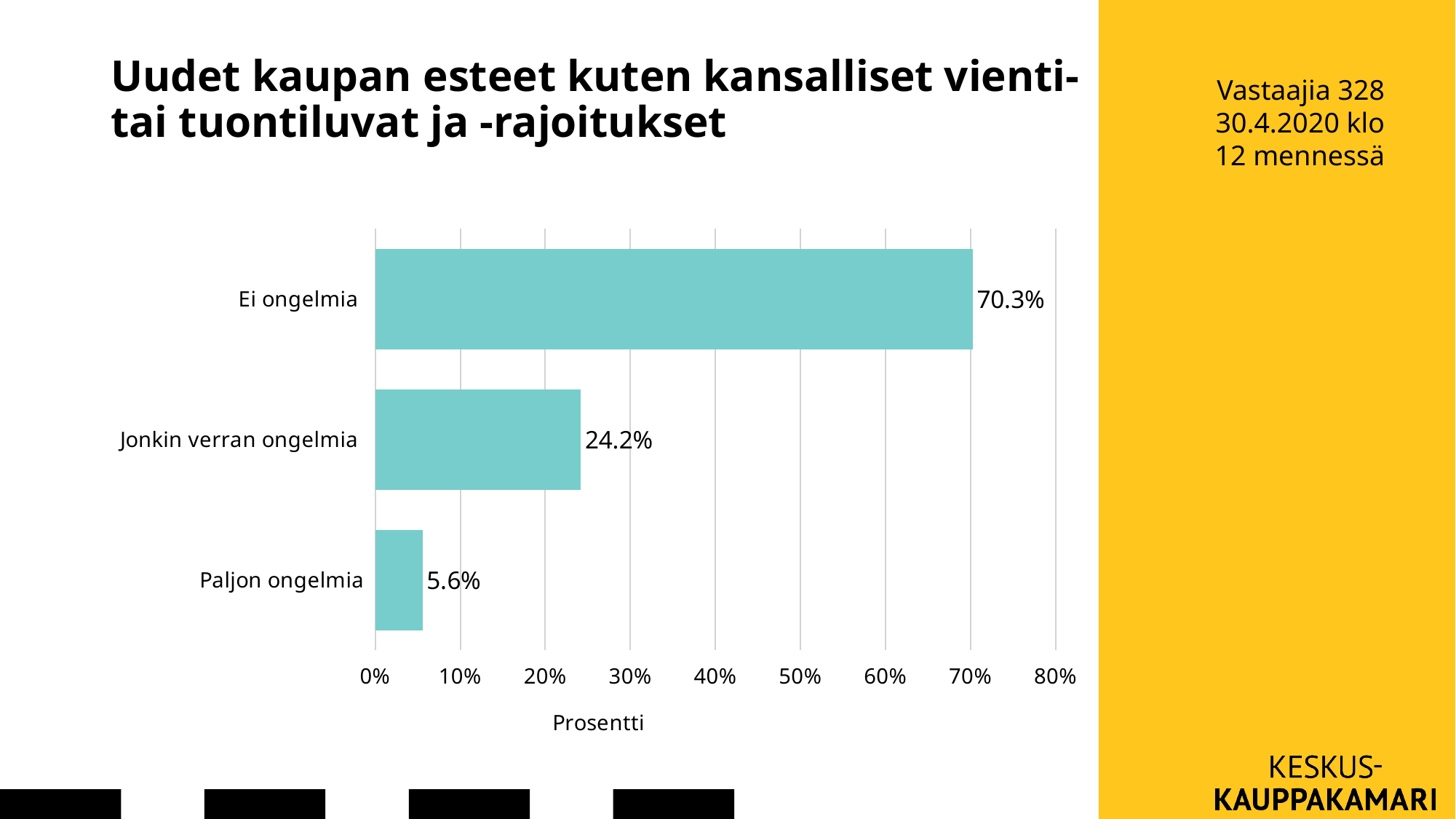
What is the difference between the values for "Ei ongelmia" and "Jonkin verran ongelmia"? 46.1% What kind of chart is shown on the slide? Bar chart Which category has the highest value? Ei ongelmia Which is larger, the value for "Jonkin verran ongelmia" or the value for "Paljon ongelmia"? Jonkin verran ongelmia What is the value for "Jonkin verran ongelmia"? 24.2% What is the label of the horizontal axis? Prosentti What is the difference between the values for "Jonkin verran ongelmia" and "Paljon ongelmia"? 18.6% Is the value for "Ei ongelmia" greater or less than 60%? greater Which category has the lowest value? Paljon ongelmia How many categories are shown in the chart? 3 What is the value for "Ei ongelmia"? 70.3% What is the value for "Paljon ongelmia"? 5.6%